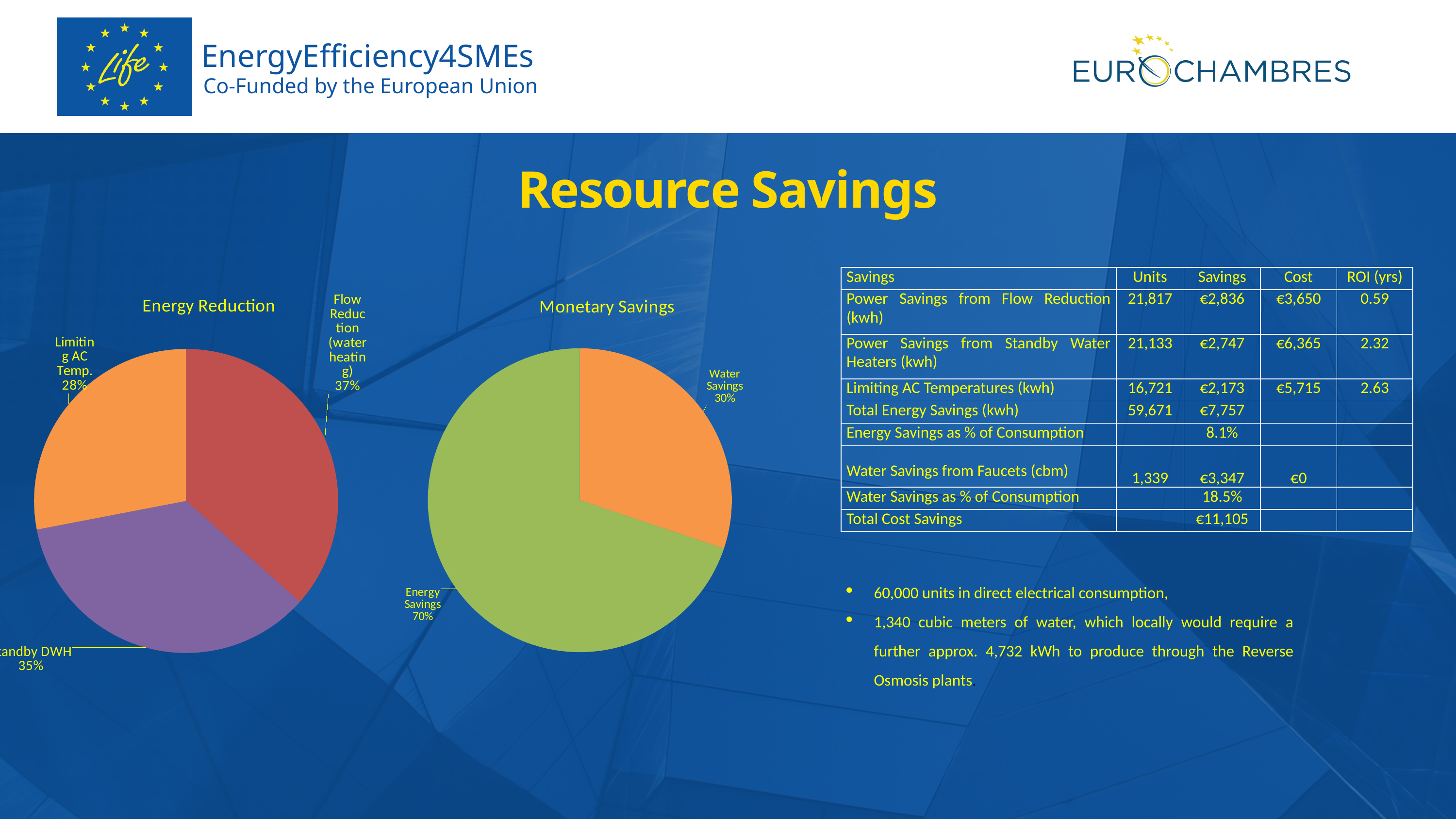
In the Energy Reduction chart, what share does Limiting AC Temp. have? 28% In the Energy Reduction chart, which slice is the largest? Flow Reduction (water heating) In the Energy Reduction chart, what share does Standby DWH have? 35% In the Energy Reduction chart, how many slices are there? 3 In the Energy Reduction chart, what is the difference in percentage points between Flow Reduction (water heating) and Limiting AC Temp.? 9 In the Monetary Savings chart, what share does Water Savings have? 30% In the Monetary Savings chart, what share does Energy Savings have? 70% What kind of chart is the Monetary Savings chart? Pie chart In the Monetary Savings chart, what colour is the Energy Savings slice? Green In the Energy Reduction chart, which slice is the smallest? Limiting AC Temp. In the Energy Reduction chart, what share does Flow Reduction (water heating) have? 37% In the Monetary Savings chart, which slice is larger, Energy Savings or Water Savings? Energy Savings